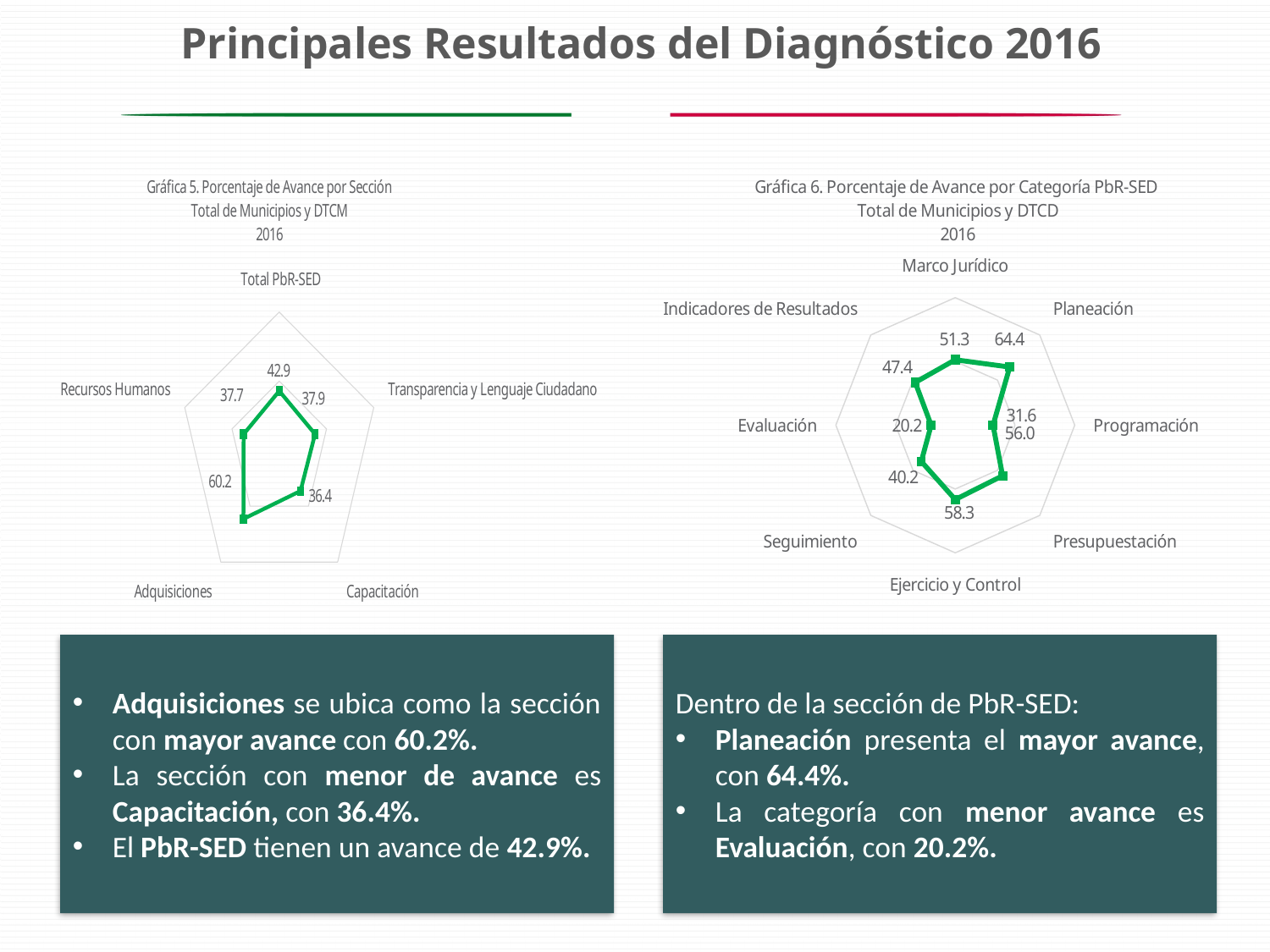
In Gráfica 6, what is the value for Evaluación? 20.2 What type of chart is Gráfica 6? Radar chart In Gráfica 5, what is the value for Total PbR-SED? 42.9 In Gráfica 5, which section has the highest value? Adquisiciones In Gráfica 6, which category has the lowest value? Evaluación In Gráfica 5, what is the value for Capacitación? 36.4 In Gráfica 5, what is the difference between Adquisiciones and Capacitación? 23.8 In Gráfica 6, which is larger, Marco Jurídico or Indicadores de Resultados? Marco Jurídico In Gráfica 6, what is the value for Planeación? 64.4 In Gráfica 5, which section has the lowest value? Capacitación In Gráfica 5, how many sections are plotted? 5 In Gráfica 5, what is the value for Adquisiciones? 60.2